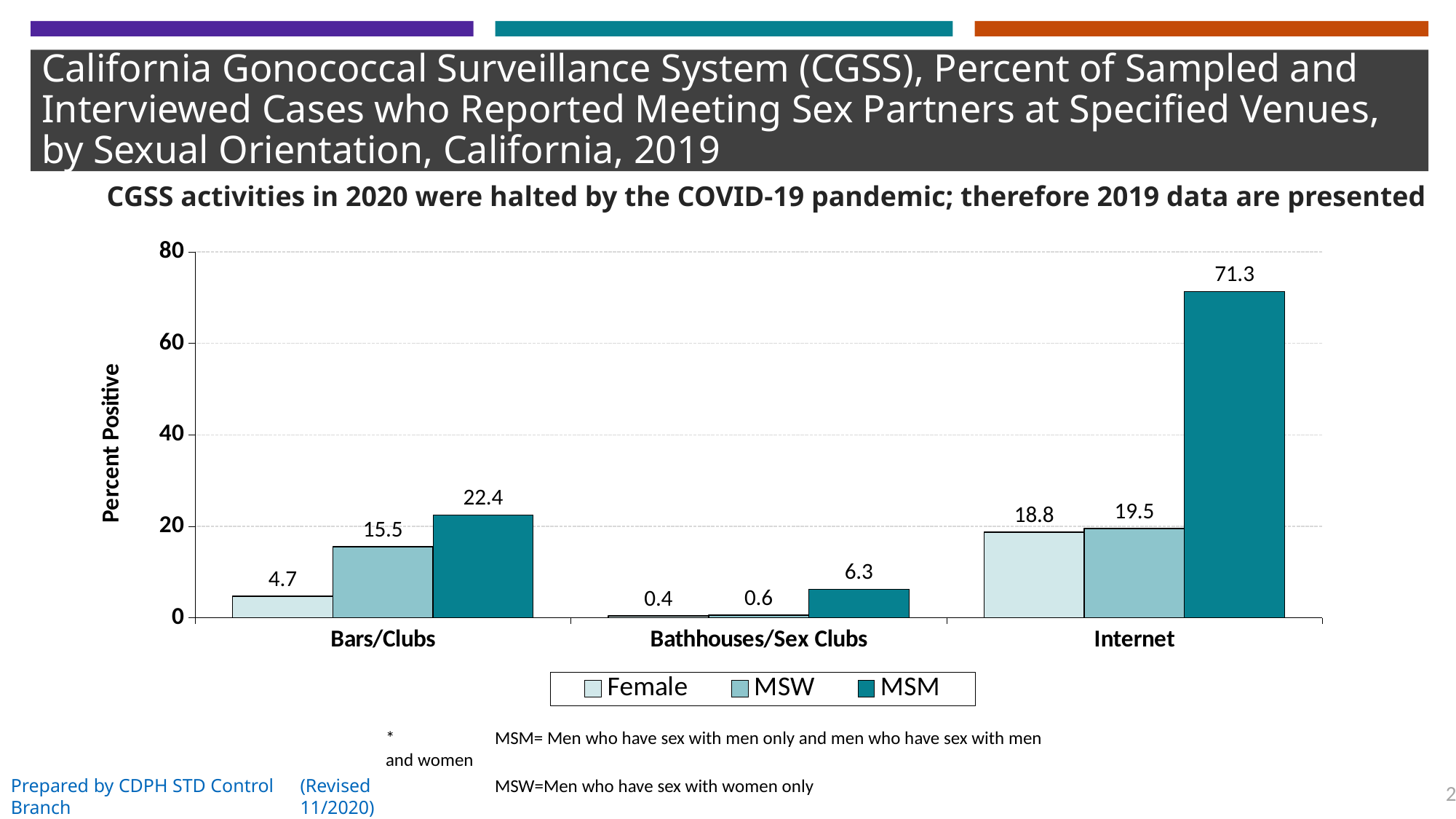
How many venue categories are shown on the x axis? 3 Which venue has the lowest value for Female? Bathhouses/Sex Clubs Is the value for MSM at Internet greater or less than 60? greater What kind of chart is shown on the slide? bar chart Which is larger at Internet: the Female value or the MSM value? MSM What is the value for MSW at Bathhouses/Sex Clubs? 0.6 What is the label of the y axis? Percent Positive What is the value for Female at Bars/Clubs? 4.7 How many series does the legend list? 3 What is the value for MSM at Internet? 71.3 What is the difference between the MSM and MSW values at Bars/Clubs? 6.9 Which venue has the highest value for MSM? Internet